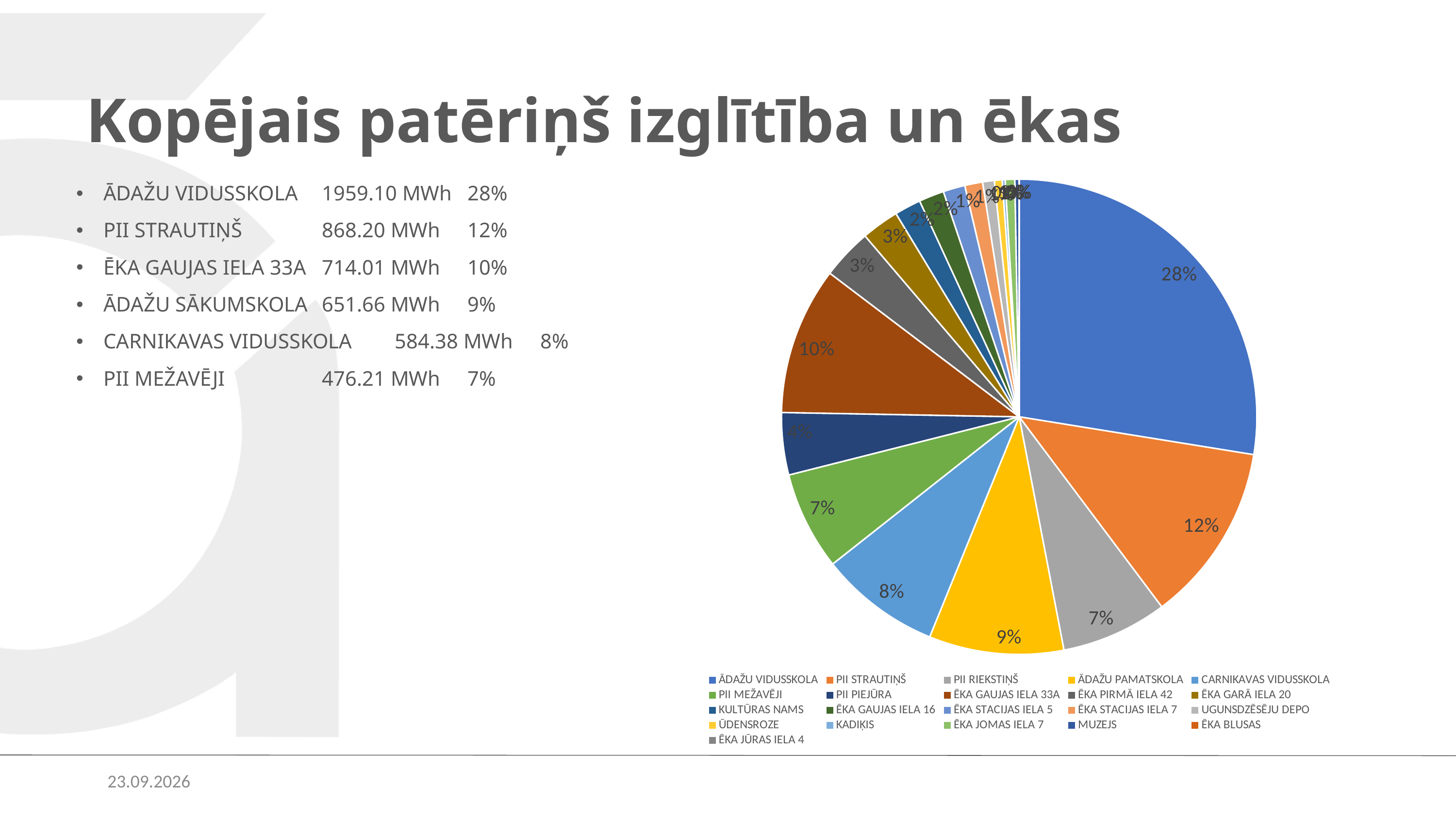
What kind of chart is shown on the slide? pie chart How many categories does the pie chart's legend list? 21 What share of the pie does ĒKA GAUJAS IELA 33A have? 10% What share of the pie does ĀDAŽU VIDUSSKOLA have? 28% What is the difference in percentage points between the shares of ĀDAŽU VIDUSSKOLA and PII STRAUTIŅŠ? 16% What share of the pie does CARNIKAVAS VIDUSSKOLA have? 8% What colour is the slice for ĀDAŽU VIDUSSKOLA in the pie chart? blue Which has a larger share of the pie, PII STRAUTIŅŠ or ĒKA GAUJAS IELA 33A? PII STRAUTIŅŠ Which category has the largest slice in the pie chart? ĀDAŽU VIDUSSKOLA